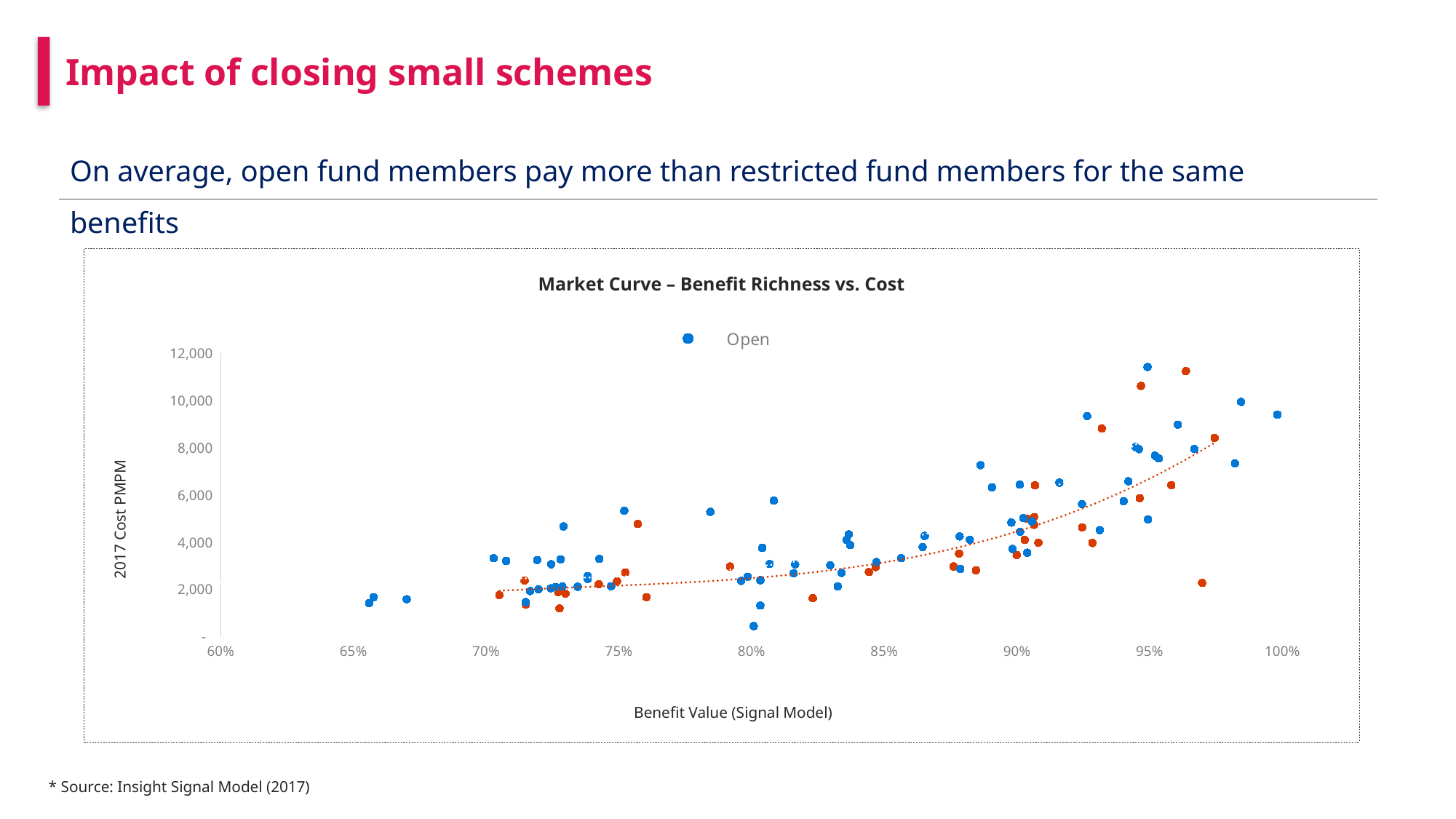
Is the lowest plotted 2017 Cost PMPM value greater or less than 2,000? less Is the cost of the rightmost plotted point (near 100% benefit value) greater or less than 8,000? greater What is the title of the chart? Market Curve – Benefit Richness vs. Cost Is the highest plotted 2017 Cost PMPM value greater or less than 10,000? greater What kind of chart is shown on the slide? Scatter chart Do the plotted cost values generally rise or fall as benefit value increases along the x axis? Rise What is the label of the series shown in the legend? Open How many series does the chart's legend list? 1